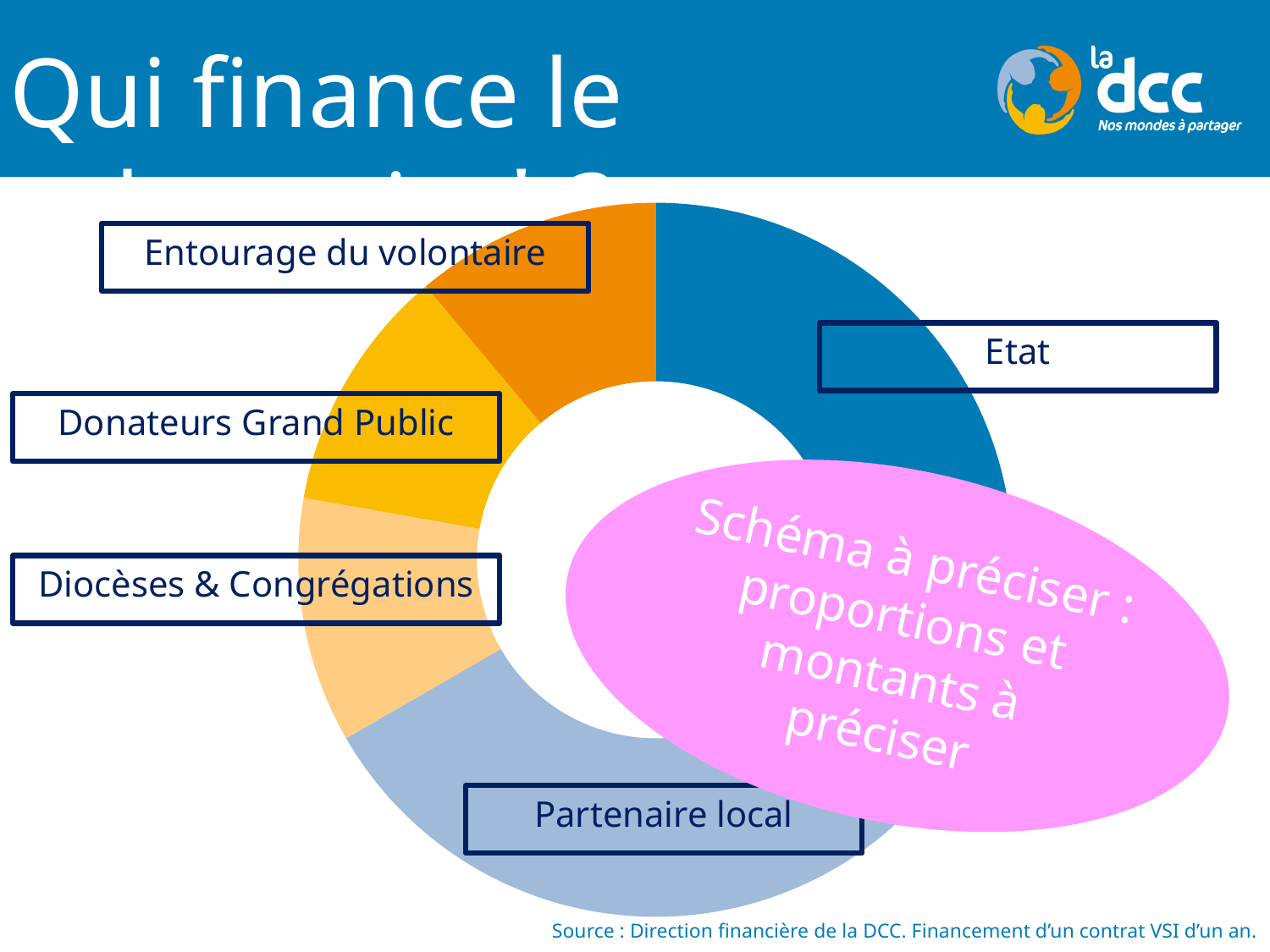
Which segment is larger, Partenaire local or Entourage du volontaire? Partenaire local How many segments does the donut chart have? 5 Which segment is larger, Etat or Diocèses & Congrégations? Etat What colour is the Etat segment of the donut chart? Dark blue What kind of chart is shown on the slide? Donut (pie) chart Which segment is larger, Etat or Donateurs Grand Public? Etat What source is cited below the chart? Direction financière de la DCC. Financement d'un contrat VSI d'un an.